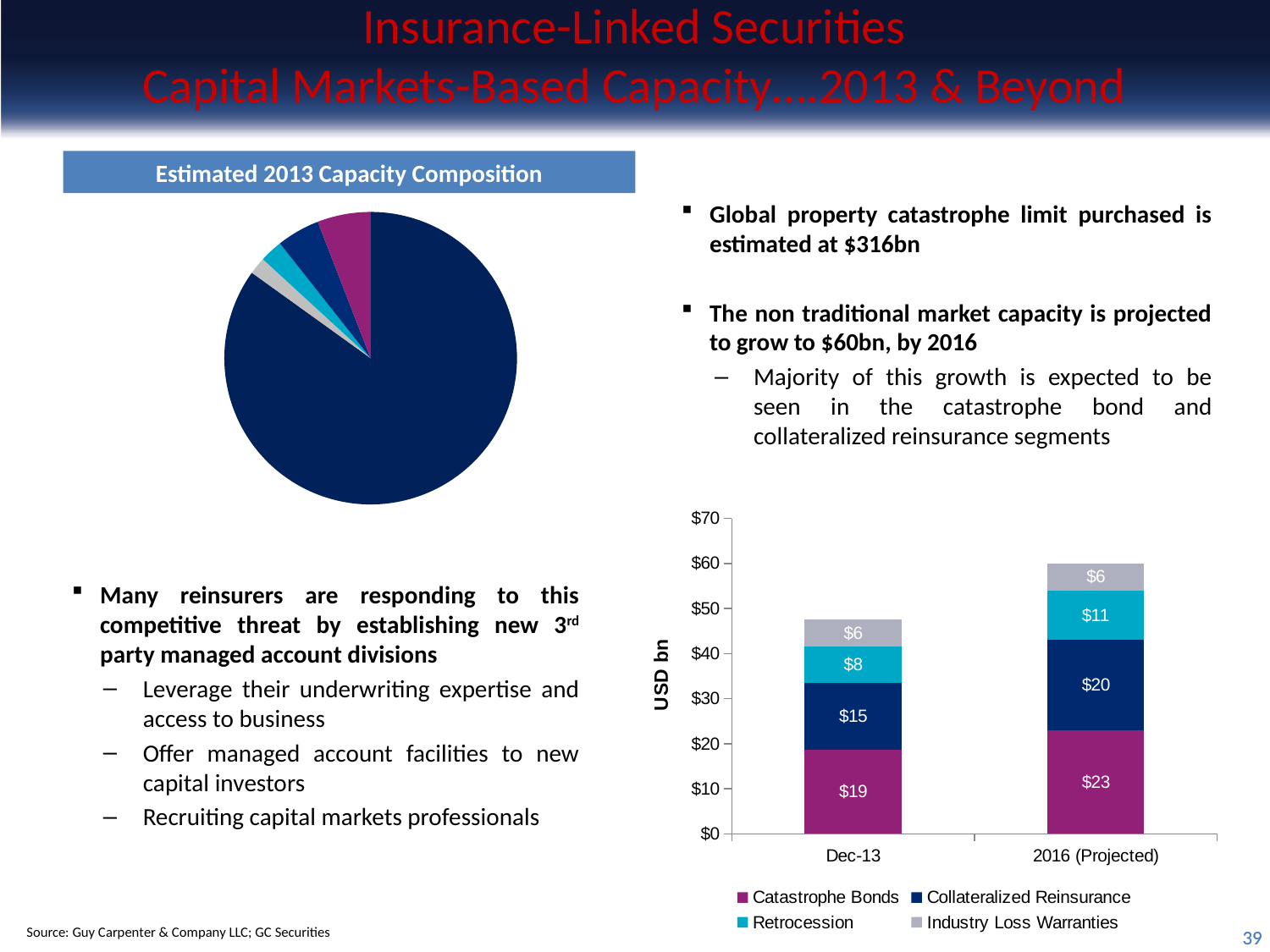
What kind of chart is the 'Estimated 2013 Capacity Composition' chart on the left? Pie chart In the stacked bar chart on the right, which segment is the largest in the Dec-13 bar? Catastrophe Bonds In the stacked bar chart on the right, what is the value for Catastrophe Bonds in Dec-13? $19 In the stacked bar chart on the right, what is the value for Retrocession in Dec-13? $8 In the stacked bar chart on the right, what is the total of the 2016 (Projected) bar? $60 In the stacked bar chart on the right, by how much does Catastrophe Bonds increase from Dec-13 to 2016 (Projected)? $4 In the stacked bar chart on the right, is Collateralized Reinsurance larger in Dec-13 or in 2016 (Projected)? 2016 (Projected) What is the y-axis label of the stacked bar chart on the right? USD bn In the stacked bar chart on the right, what is the value for Collateralized Reinsurance in 2016 (Projected)? $20 How many series does the legend of the stacked bar chart on the right list? 4 In the stacked bar chart on the right, what is the total of the Dec-13 bar? $48 In the stacked bar chart on the right, what is the value for Industry Loss Warranties in 2016 (Projected)? $6